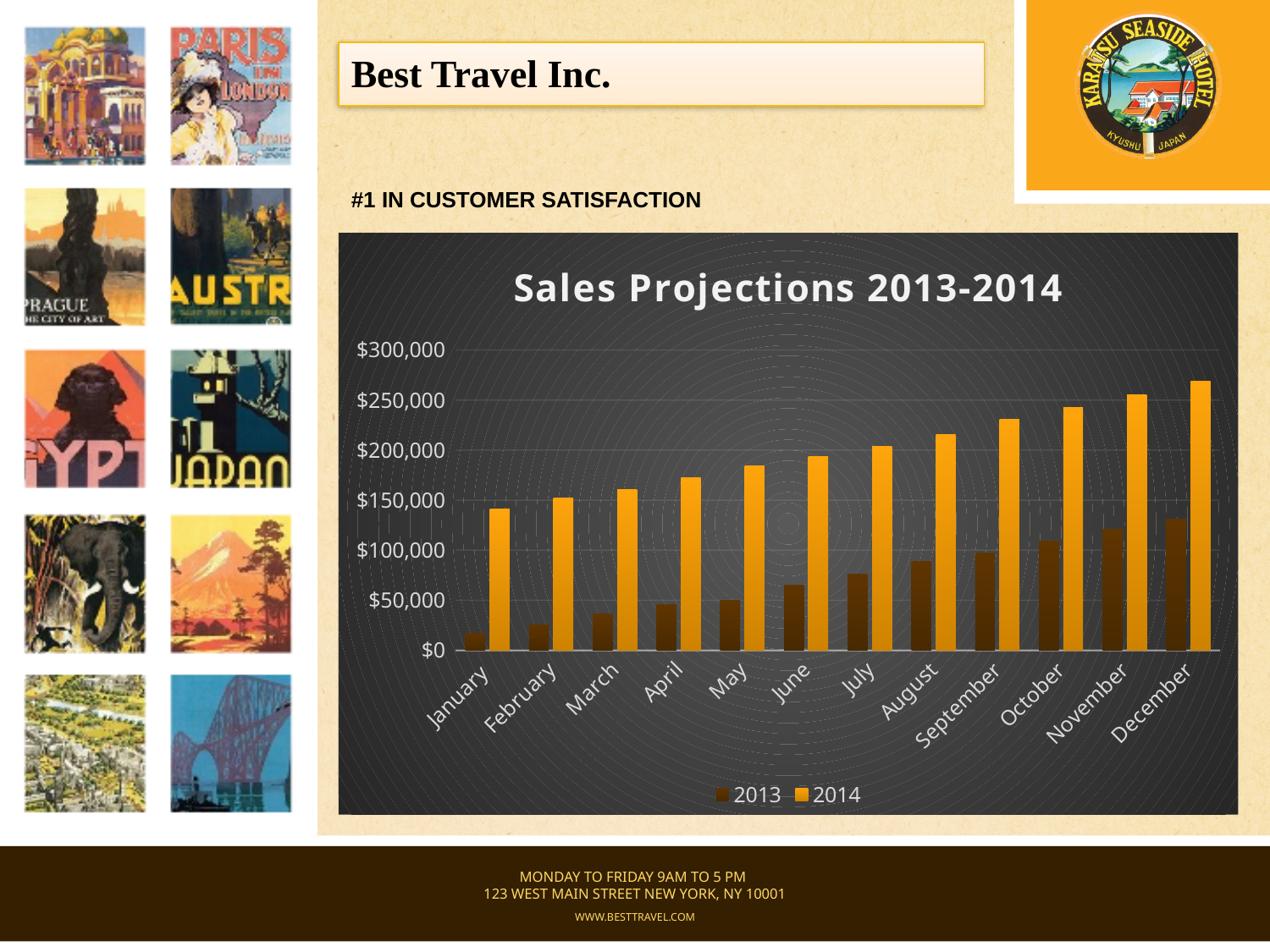
Is the 2014 value for December greater or less than $250,000? greater Is the 2013 value for January greater or less than $50,000? less Is the 2013 value for December greater or less than $100,000? greater Do the 2014 values rise or fall from January to December? rise What is the title of the chart? Sales Projections 2013-2014 What type of chart is shown on the slide? bar chart How many months are shown on the x axis? 12 In March, which series has the larger value, 2013 or 2014? 2014 How many series does the legend list? 2 Which month has the lowest value for the 2013 series? January Which month has the highest value for the 2014 series? December